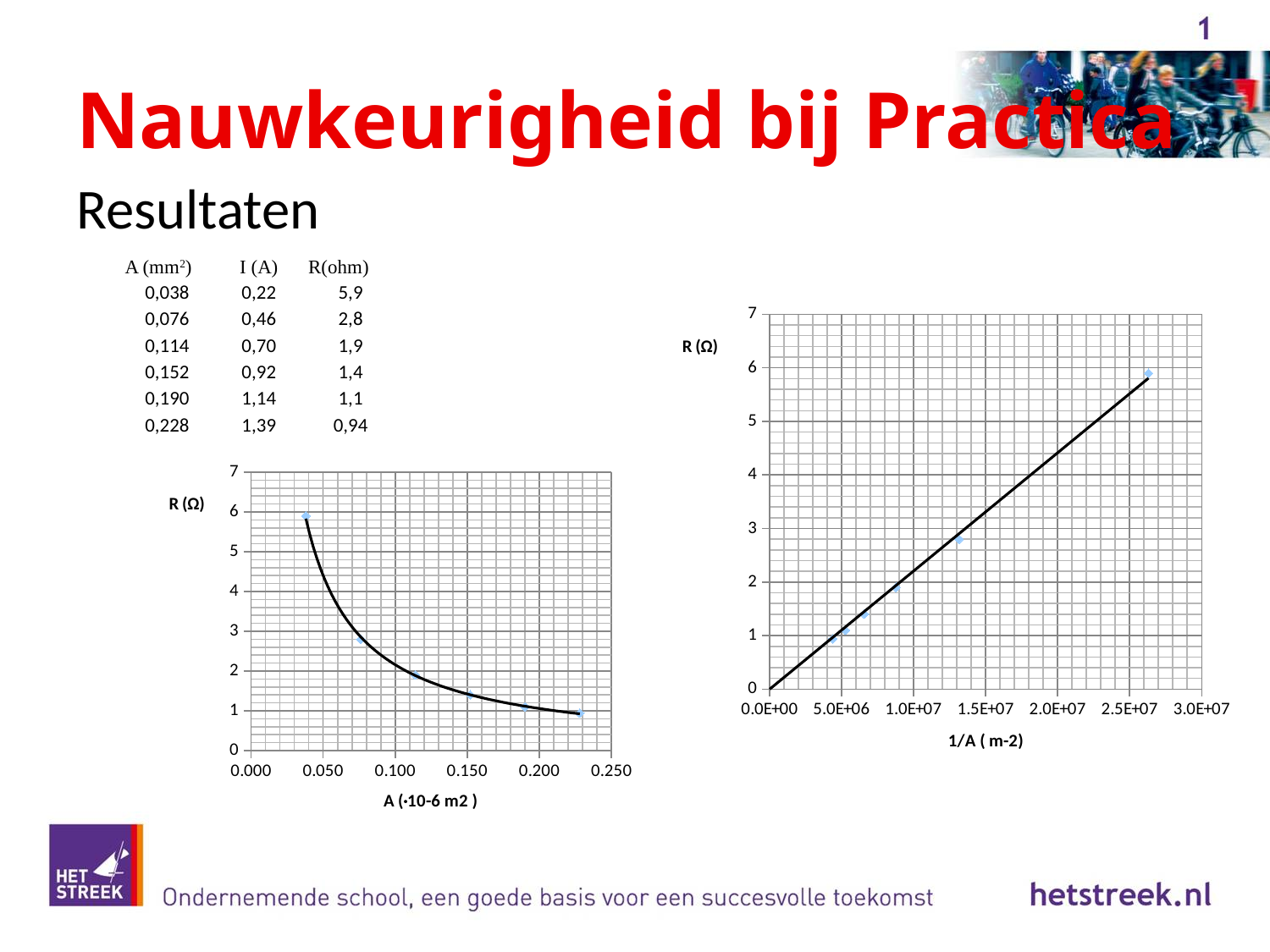
What is the label on the y axis of the left chart? R (Ω) In the right chart, is the R value of the rightmost data point greater or less than 5? greater In the left chart, is the R value of the leftmost data point greater or less than 5? greater In the left chart, do the R values rise or fall as A increases along the x axis? fall In the right chart, do the R values rise or fall as 1/A increases along the x axis? rise What is the label on the x axis of the right chart? 1/A ( m-2) How many data points are plotted in the left chart? 6 In the right chart, is the R value of the data point near 1.3E+07 on the x axis greater or less than 4? less What kind of chart is the left chart (R against A)? scatter chart In the left chart, is R highest at the smallest or the largest value of A? smallest What kind of chart is the right chart (R against 1/A)? scatter chart